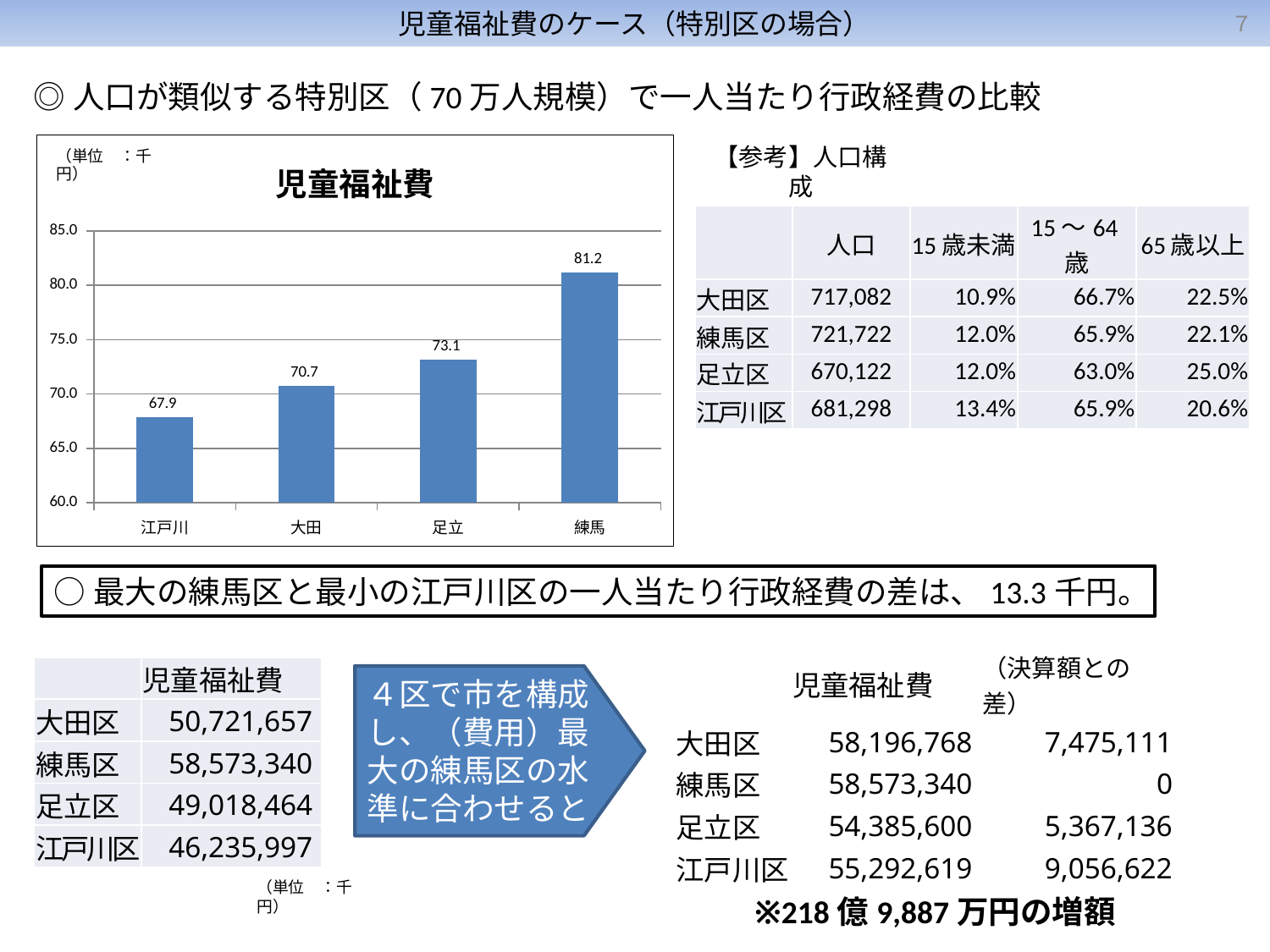
What is the value for 江戸川 in the chart? 67.9 Which category has the highest value in the chart? 練馬 What is the value for 練馬 in the chart? 81.2 Do the values rise or fall from left to right along the x axis? rise What is the value for 足立 in the chart? 73.1 What is the title of the chart? 児童福祉費 What type of chart is shown on the slide? bar chart Which category has the lowest value in the chart? 江戸川 What is the value for 大田 in the chart? 70.7 What is the difference between the values for 練馬 and 江戸川? 13.3 How many categories are shown in the chart? 4 Which is larger, the value for 足立 or the value for 大田? 足立